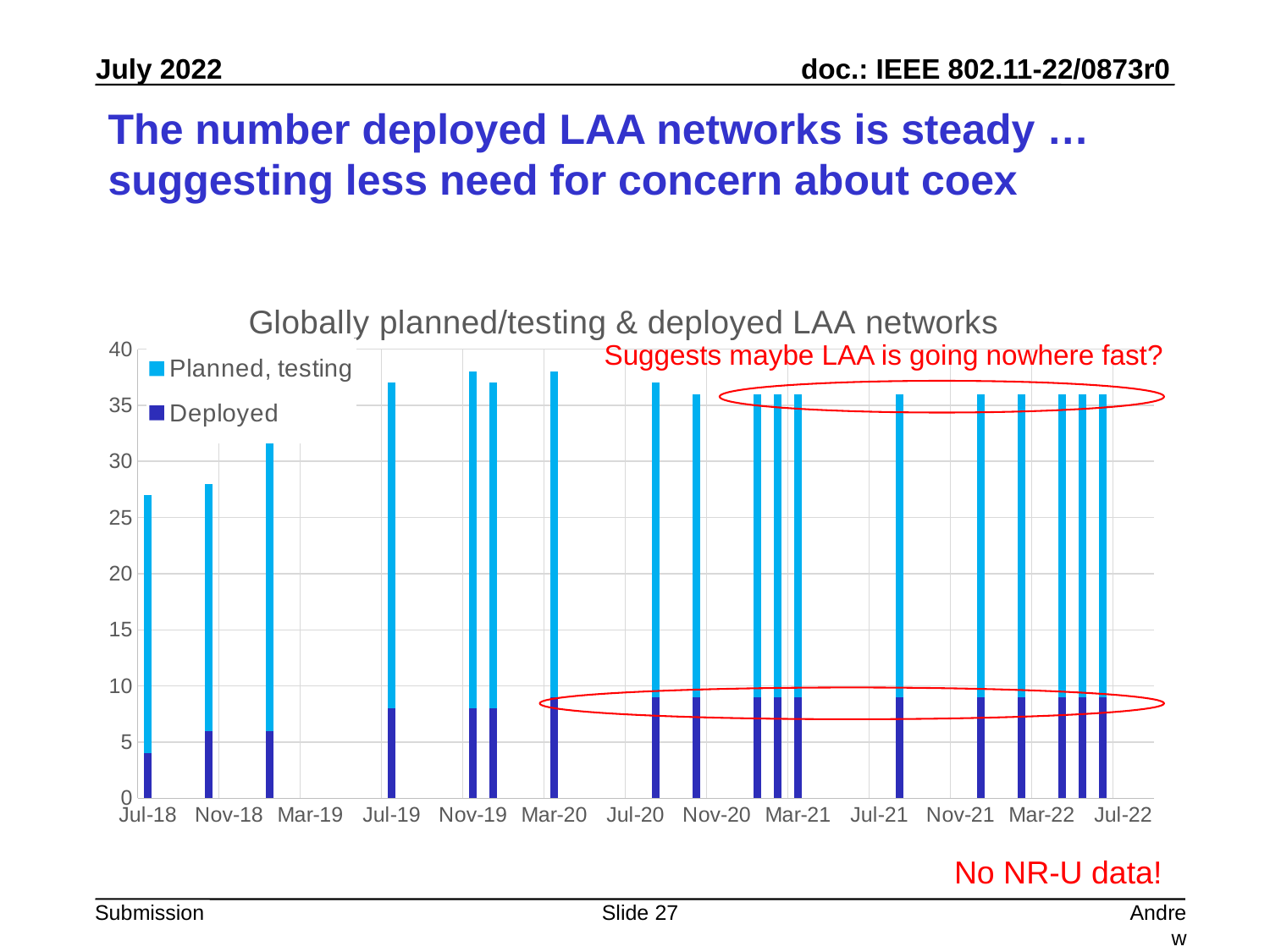
Is the total height of the Jul-19 bar greater or less than 35? greater Is the Deployed value for Jul-19 greater or less than 5? greater How many series does the chart legend list? 2 Which labeled month has the lowest total bar height? Jul-18 Which series is shown in dark blue in the chart? Deployed Is the Deployed value for Jul-18 greater or less than 5? less Does the Deployed value generally rise or fall from Jul-18 to Jul-22? rise What is the title of the chart? Globally planned/testing & deployed LAA networks Which is larger, the total bar for Jul-18 or the total bar for Jul-19? Jul-19 What kind of chart is shown on the slide? stacked bar chart